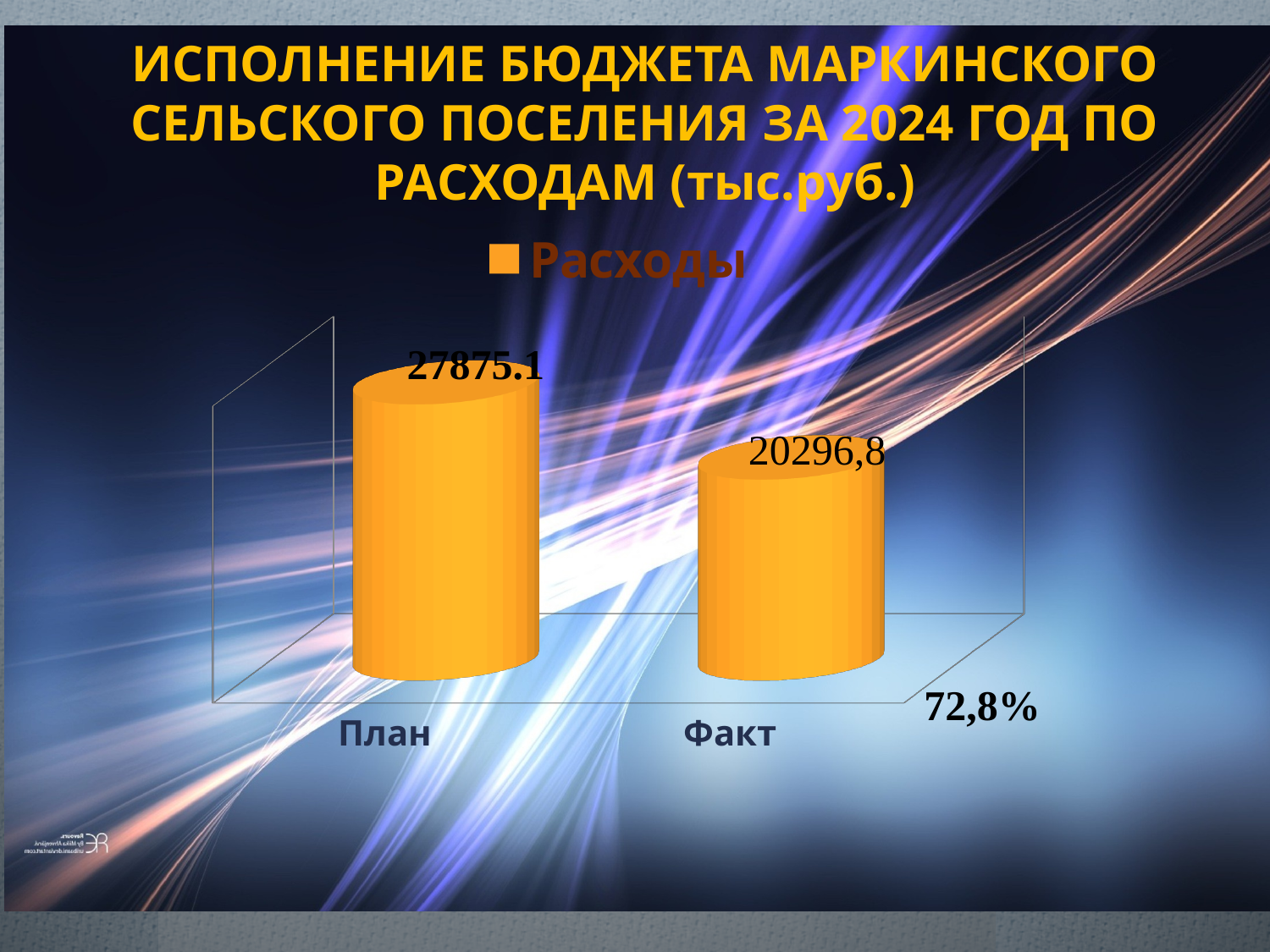
What is the difference between the value for План and the value for Факт? 7578,3 What series name is shown in the chart legend? Расходы Which category has the highest value? План Do the values rise or fall from План to Факт? Fall What percentage is printed next to the Факт bar on the slide? 72,8% What is the value for План? 27875.1 What is the value for Факт? 20296,8 Which is larger, the value for План or the value for Факт? План How many series does the legend list? 1 How many categories are shown on the chart? 2 What kind of chart is shown on the slide? Bar chart Which category has the lowest value? Факт